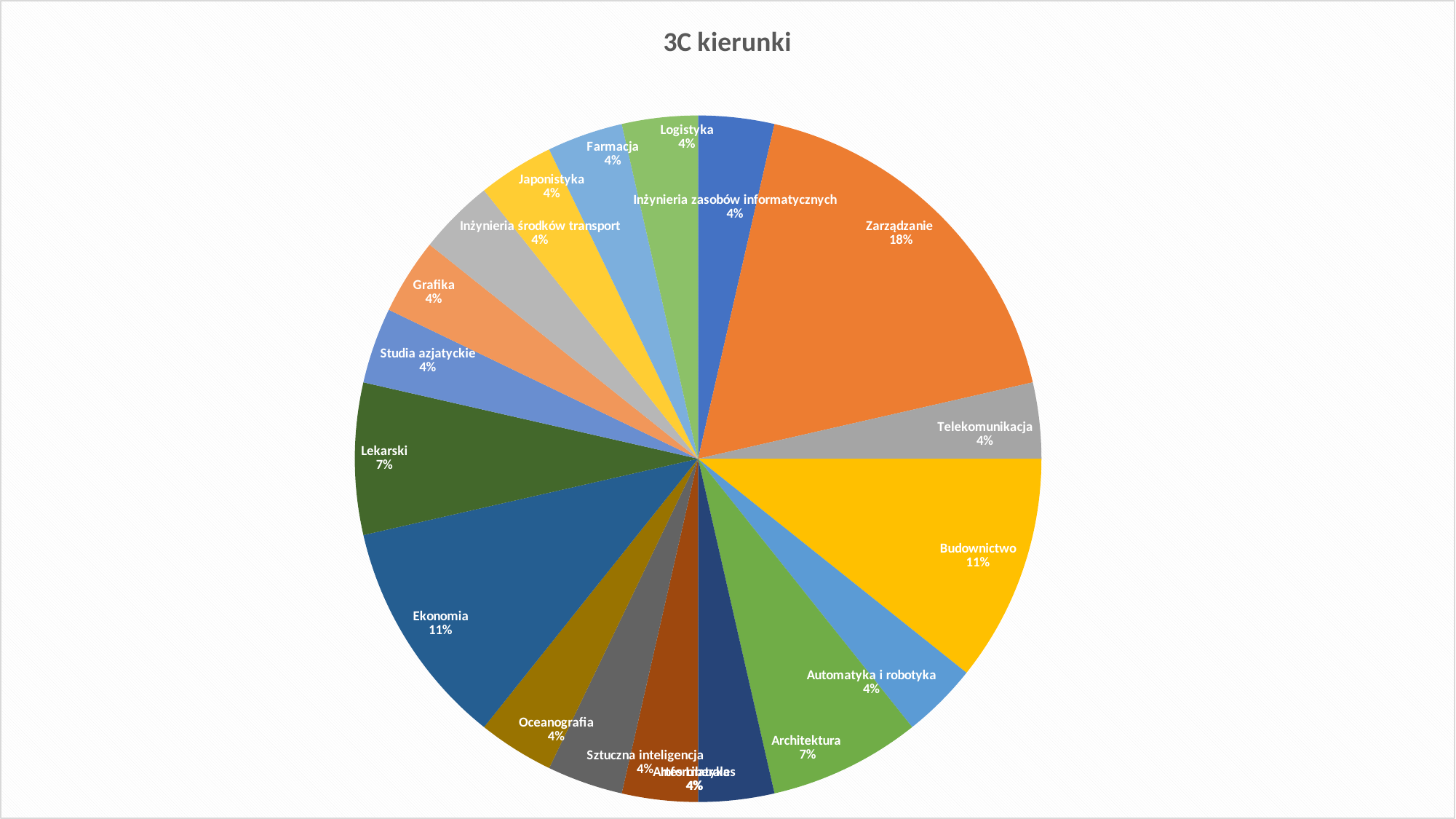
What is the title of the chart? 3C kierunki What percentage is shown for Lekarski? 7% What is the difference in percentage points between Zarządzanie and Budownictwo? 7 Which is larger, Ekonomia or Lekarski? Ekonomia What type of chart is shown on the slide? pie chart How many slices does the pie chart have? 18 Which category has the largest slice of the pie? Zarządzanie What is the difference in percentage points between Ekonomia and Oceanografia? 7 What percentage is shown for Architektura? 7% What share of the pie does Zarządzanie have? 18% What share of the pie does Budownictwo have? 11% What percentage is shown for Telekomunikacja? 4%